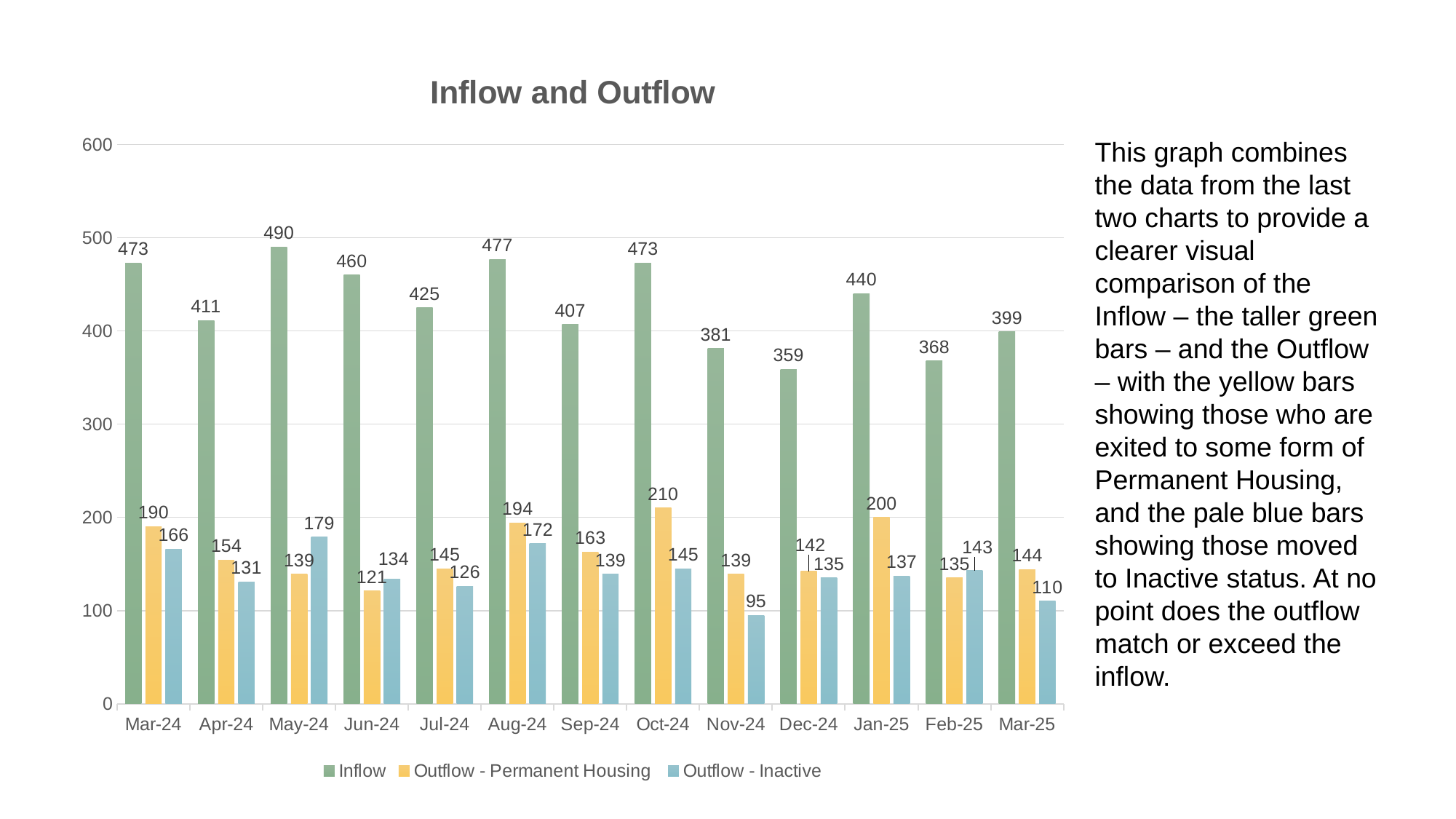
Which is larger for Jun-24: Outflow - Permanent Housing or Outflow - Inactive? Outflow - Inactive How many months are shown on the x axis? 13 Which month has the lowest Outflow - Inactive value? Nov-24 What is the Inflow value for May-24? 490 What is the Outflow - Inactive value for Nov-24? 95 What is the title of the chart? Inflow and Outflow What kind of chart is shown on the slide? Bar chart Which month has the highest Inflow value? May-24 What is the Outflow - Permanent Housing value for Oct-24? 210 How many series does the legend list? 3 Which month has the lowest Inflow value? Dec-24 What is the difference between the Inflow and the Outflow - Permanent Housing values for Jan-25? 240